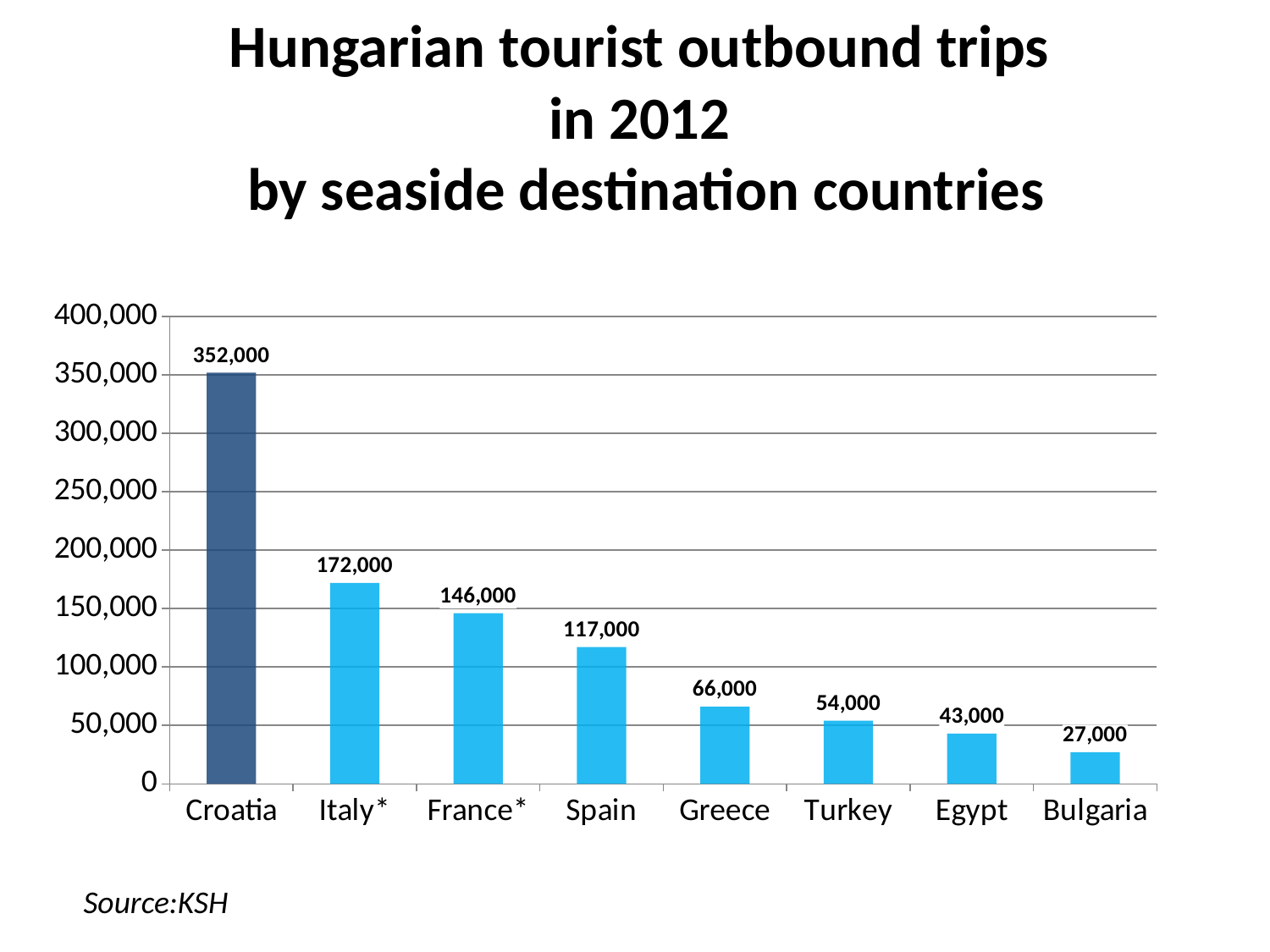
What kind of chart is shown on the slide? Bar chart Which destination country has the highest number of trips? Croatia What is the difference between the values for Croatia and Bulgaria? 325,000 Which has a larger value, Greece or Turkey? Greece Which bar is shown in a different (darker) colour from the others? Croatia Is the value for Spain greater or less than 100,000? greater Which destination country has the lowest number of trips? Bulgaria How many outbound trips to Croatia are shown on the chart? 352,000 What is the difference between the values for Italy* and France*? 26,000 What is the value shown for Spain? 117,000 How many destination countries are shown on the chart? 8 What is the value shown for Egypt? 43,000